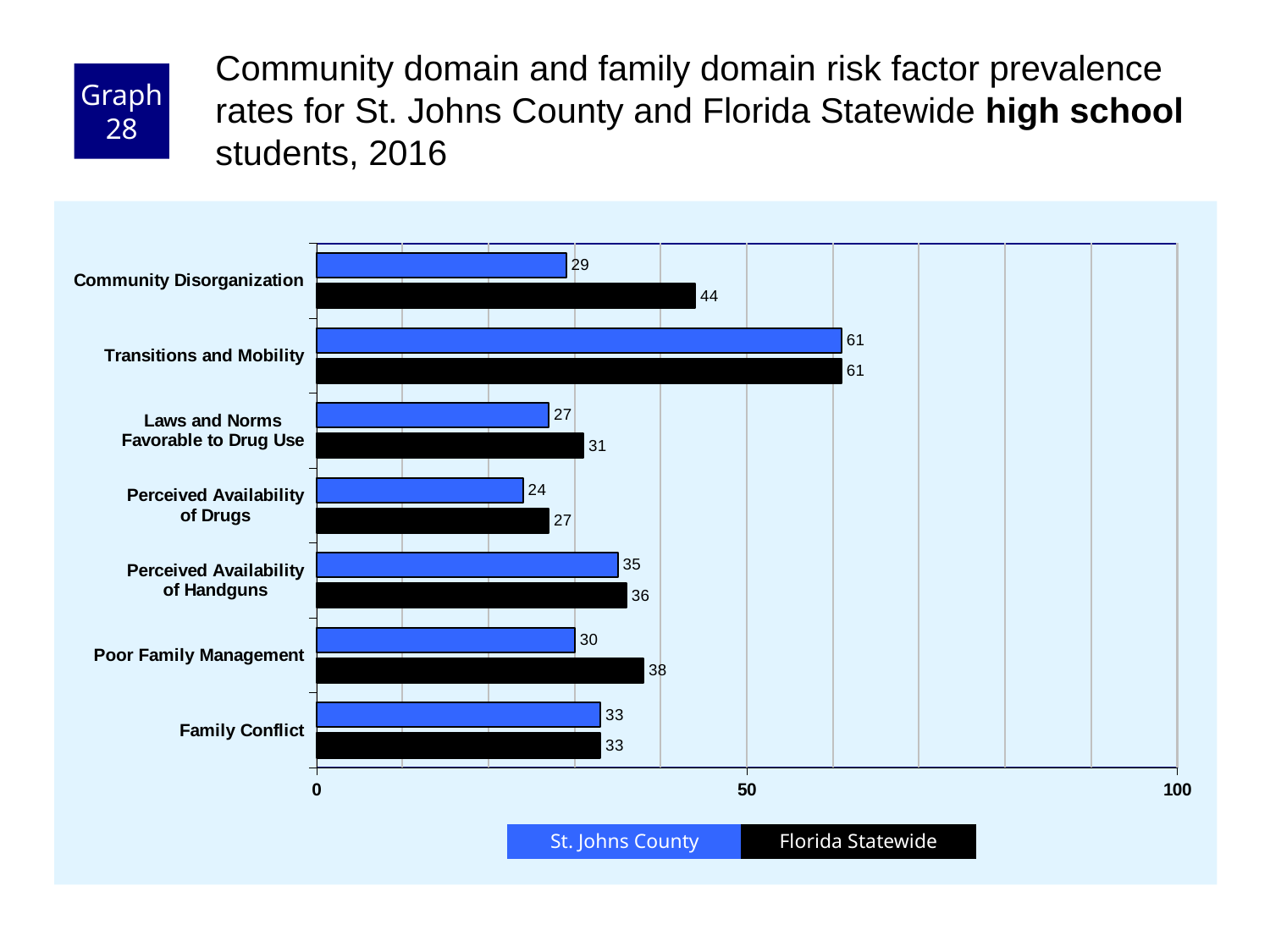
What is the Florida Statewide value for Poor Family Management? 38 What is the difference between the Florida Statewide and St. Johns County values for Community Disorganization? 15 What is the St. Johns County value for Perceived Availability of Drugs? 24 Which risk factor has the highest St. Johns County value? Transitions and Mobility Is the Florida Statewide value for Transitions and Mobility greater or less than 50? greater Which is larger for Poor Family Management: the St. Johns County value or the Florida Statewide value? Florida Statewide How many risk factors are shown on the chart? 7 Which colour represents Florida Statewide in the chart? black What kind of chart is shown on the slide? bar chart What is the St. Johns County value for Community Disorganization? 29 Which risk factor has the lowest Florida Statewide value? Perceived Availability of Drugs How many series does the legend list? 2